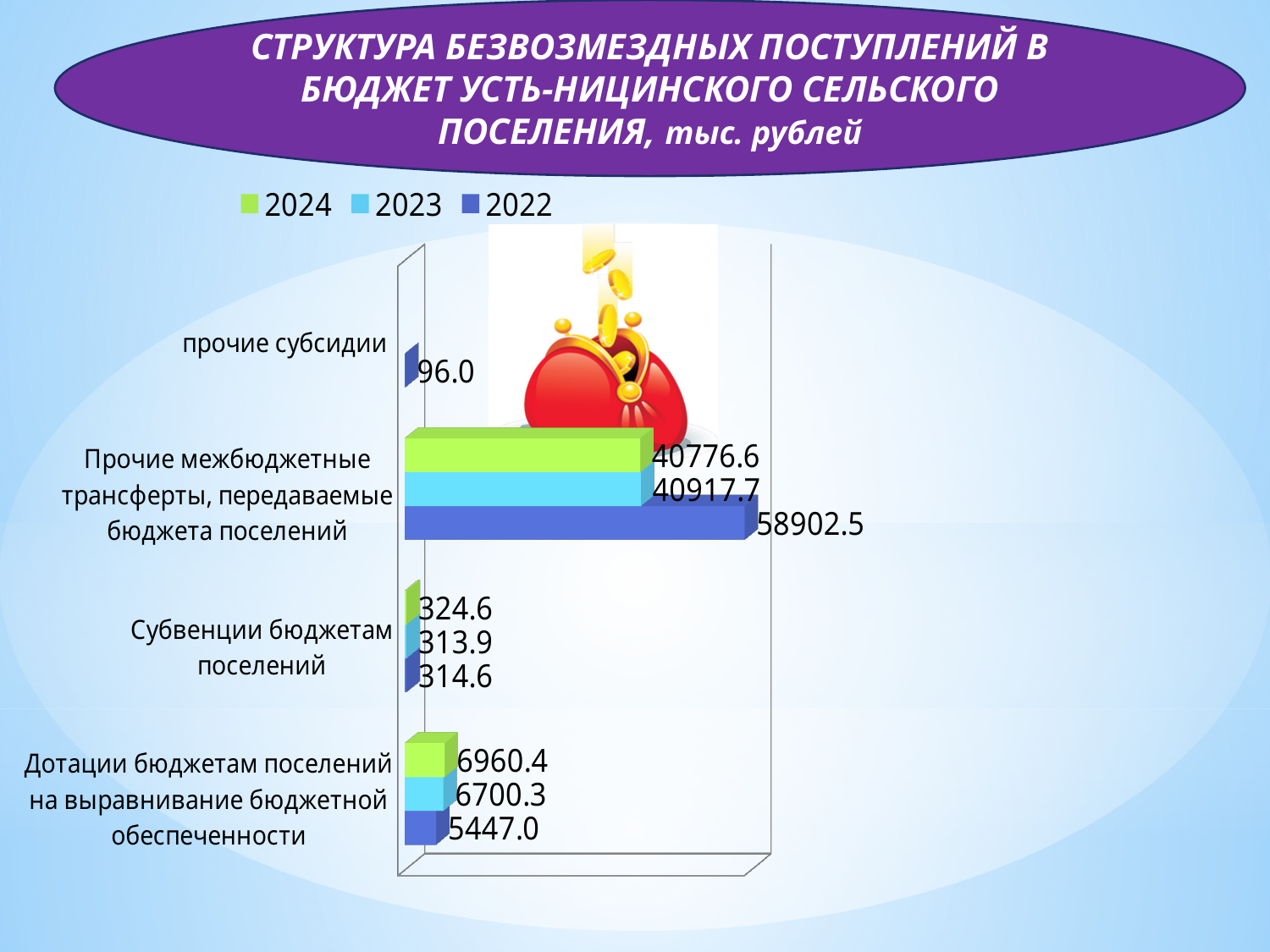
Which category has the highest 2022 value? Прочие межбюджетные трансферты, передаваемые бюджета поселений What type of chart is shown on the slide? bar chart Which colour represents the 2022 series in the legend? dark blue What is the difference between the 2024 and 2022 values for "Дотации бюджетам поселений на выравнивание бюджетной обеспеченности"? 1513.4 What is the 2023 value for "Субвенции бюджетам поселений"? 313.9 What is the 2024 value for "Прочие межбюджетные трансферты, передаваемые бюджета поселений"? 40776.6 What is the 2022 value for "прочие субсидии"? 96.0 For "Дотации бюджетам поселений на выравнивание бюджетной обеспеченности", which year has the larger value, 2024 or 2023? 2024 Which category has the lowest 2024 value? Субвенции бюджетам поселений What is the difference between the 2022 and 2023 values for "Прочие межбюджетные трансферты, передаваемые бюджета поселений"? 17984.8 What is the 2022 value for "Дотации бюджетам поселений на выравнивание бюджетной обеспеченности"? 5447.0 How many series does the legend list? 3